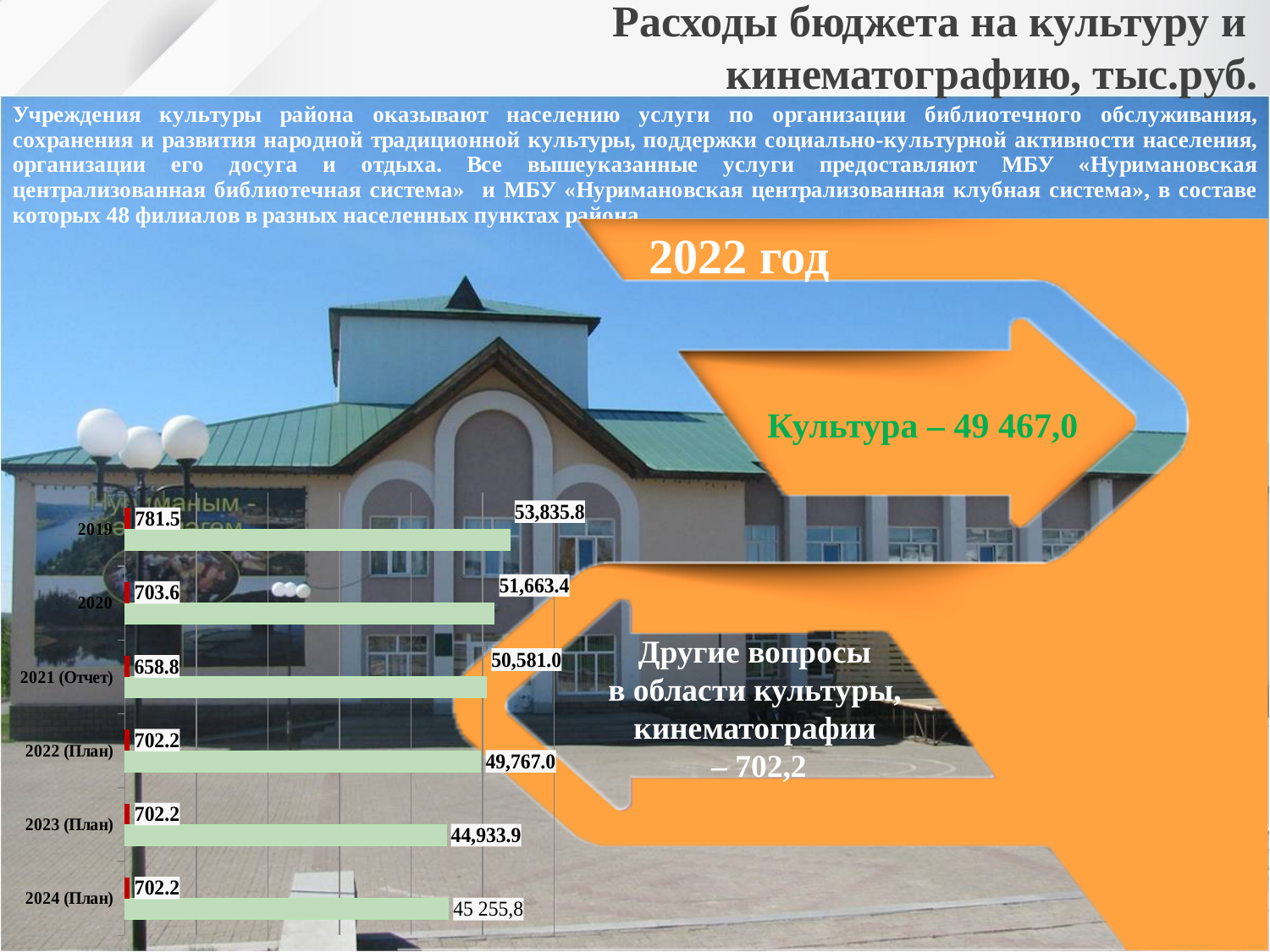
What is the value of the shorter (red) bar for 2020? 703.6 What is the value of the shorter (red) bar for 2023 (План)? 702.2 What is the value of the longer (green) bar for 2021 (Отчет)? 50,581.0 Which year has the highest value for the longer (green) bar? 2019 What type of chart is shown on the slide? bar chart What is the value of the longer (green) bar for 2024 (План)? 45 255,8 Which year has the lowest value for the longer (green) bar? 2023 (План) What is the difference between the longer (green) bar values for 2019 and 2020? 2,172.4 Is the longer (green) bar value for 2022 (План) larger or smaller than that for 2023 (План)? larger How many year categories are shown in the chart? 6 Which year has the lowest value for the shorter (red) bar? 2021 (Отчет) What is the value of the longer (green) bar for 2019? 53,835.8